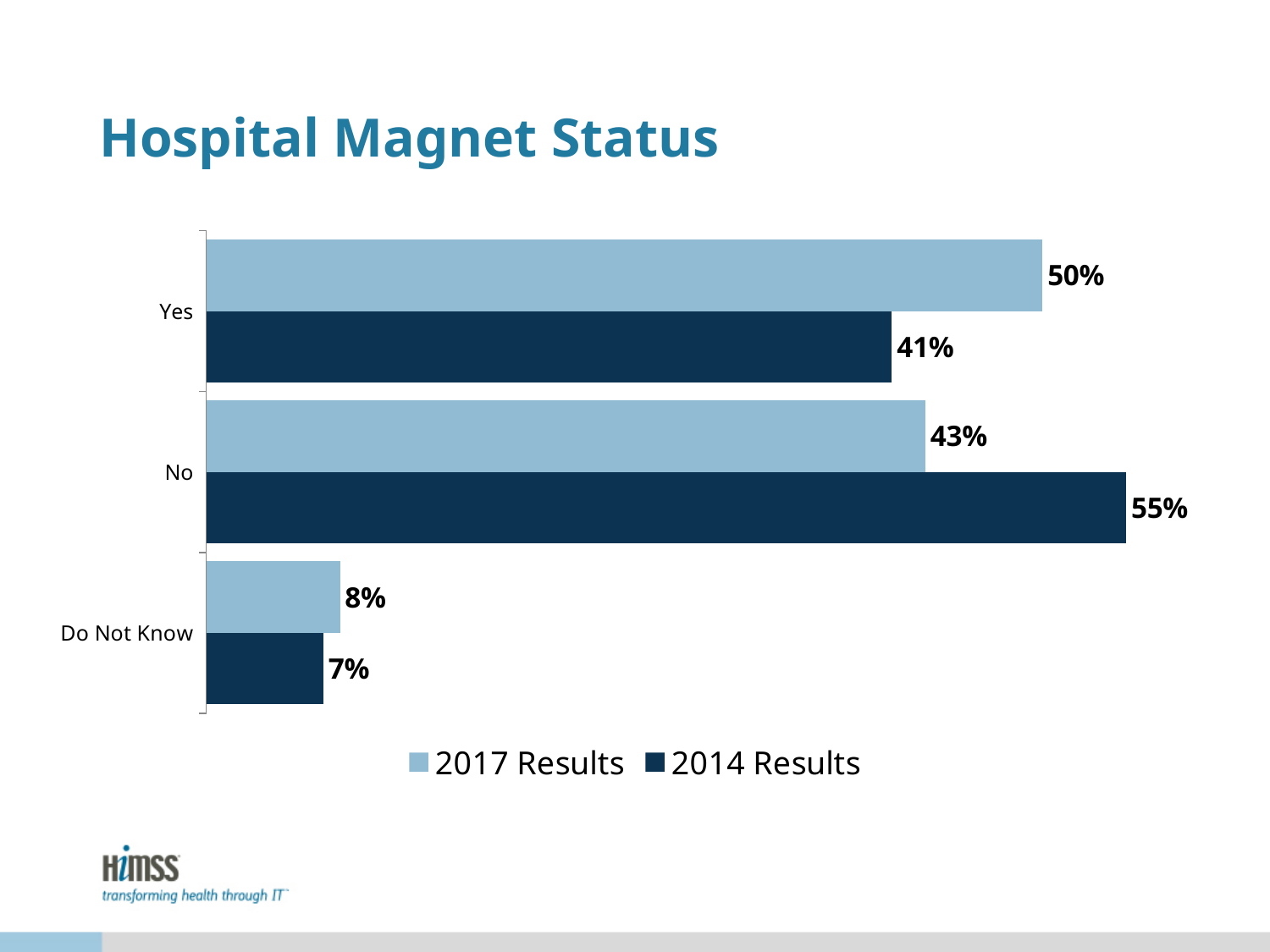
Which is larger for Do Not Know: the 2017 Results value or the 2014 Results value? 2017 Results How many series does the legend list? 2 Which category has the lowest 2014 Results value? Do Not Know What is the 2014 Results value for Yes? 41% What is the 2017 Results value for Do Not Know? 8% What is the 2014 Results value for No? 55% What is the difference between the 2014 Results and 2017 Results values for No? 12% What is the difference between the 2017 Results and 2014 Results values for Yes? 9% Which category has the highest 2017 Results value? Yes How many categories are shown on the chart? 3 What kind of chart is shown on the slide? Bar chart What is the 2017 Results value for Yes? 50%